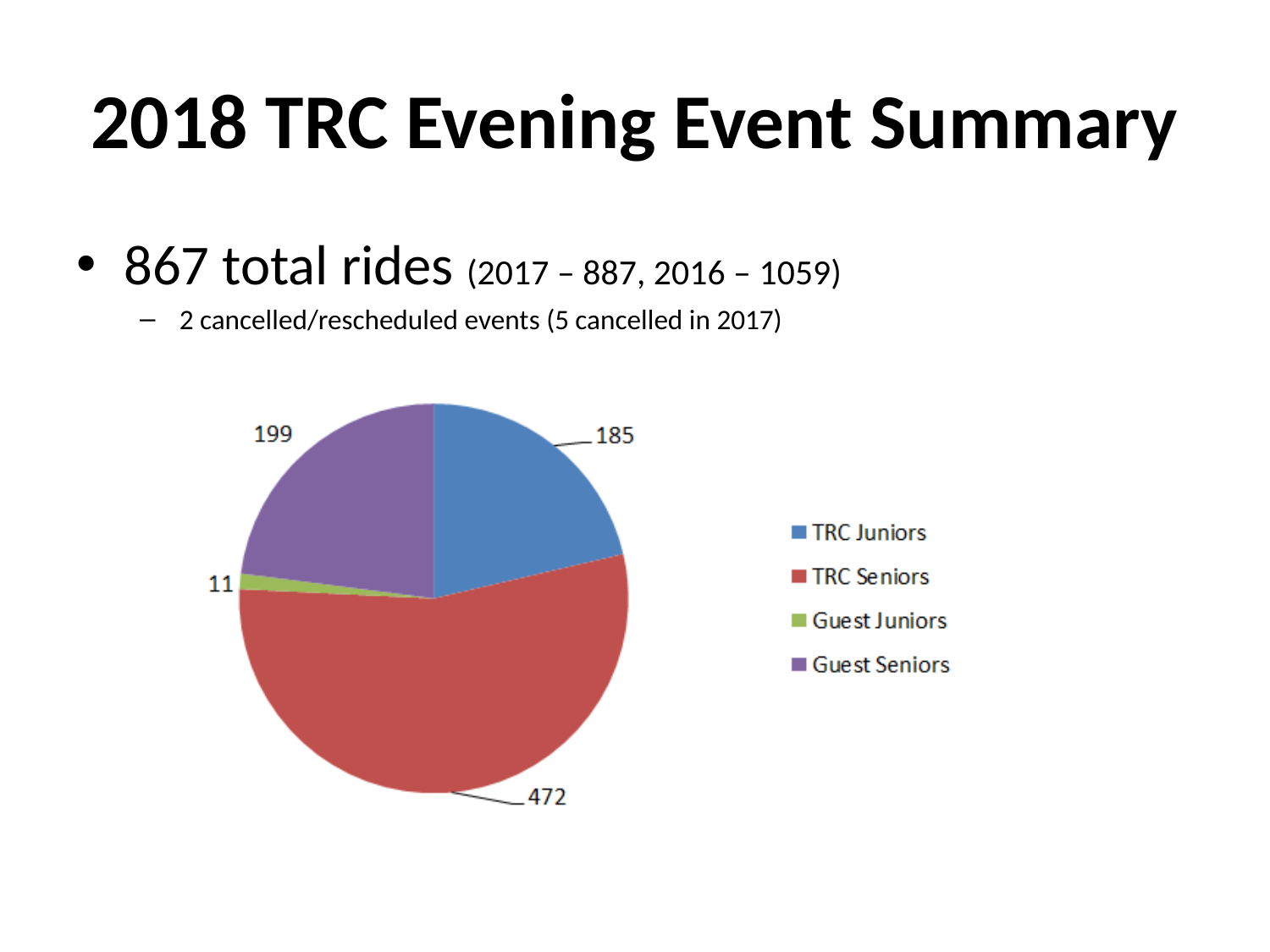
Which category has the largest slice in the pie chart? TRC Seniors What is the value for TRC Seniors in the pie chart? 472 What is the value for Guest Seniors in the pie chart? 199 Which is larger in the pie chart, Guest Seniors or TRC Juniors? Guest Seniors Which category has the smallest slice in the pie chart? Guest Juniors How many entries does the legend of the pie chart list? 4 What is the value for TRC Juniors in the pie chart? 185 What is the value for Guest Juniors in the pie chart? 11 What is the difference between the TRC Seniors value and the TRC Juniors value in the pie chart? 287 What kind of chart is shown on the slide? pie chart How many slices does the pie chart have? 4 What colour is the TRC Seniors slice in the pie chart? red